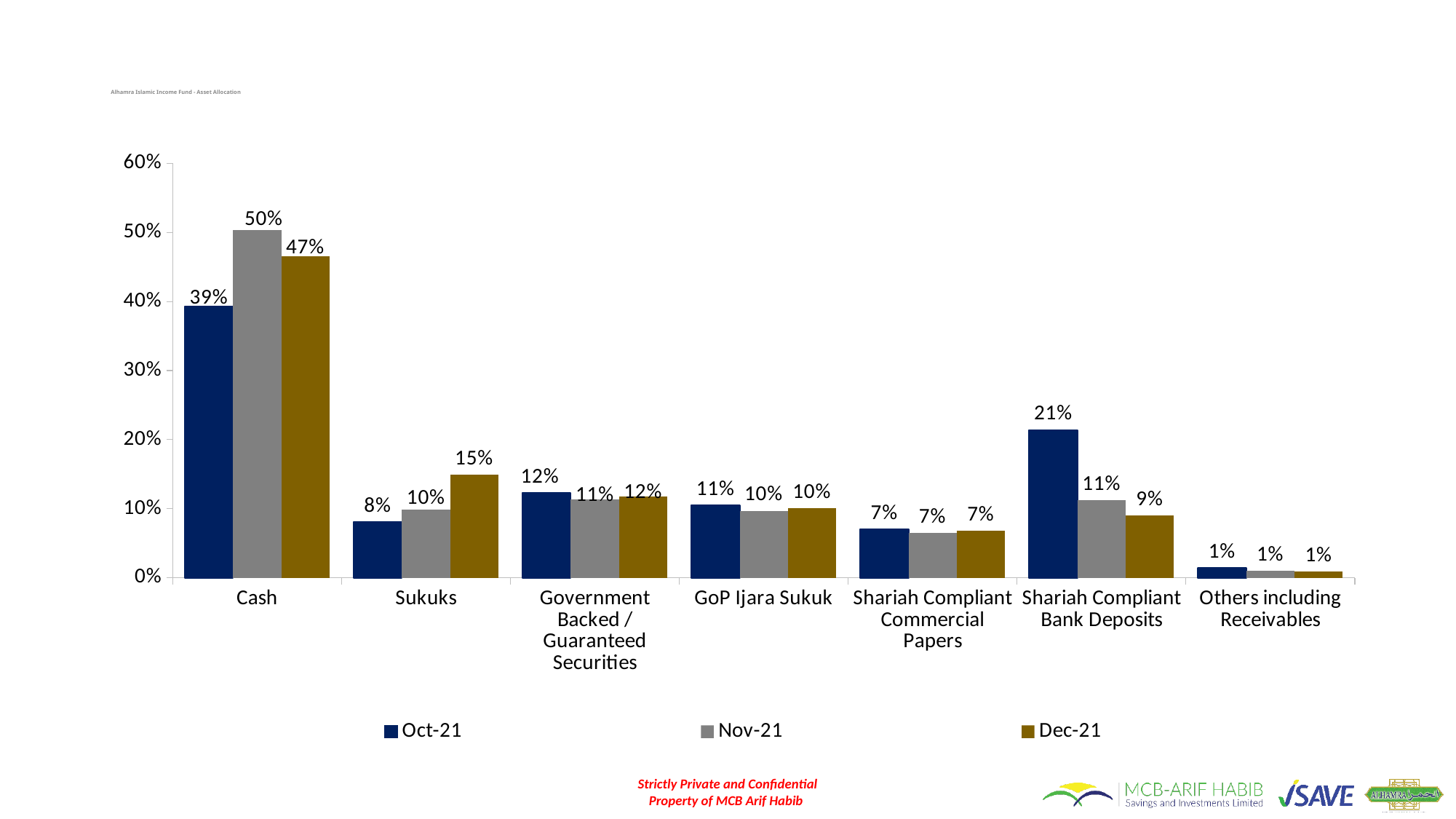
Which category has the lowest Dec-21 value? Others including Receivables What is the Oct-21 value for Shariah Compliant Bank Deposits? 21% What is the difference between the Nov-21 and Oct-21 values for Cash? 11% Which is larger for Sukuks: the Oct-21 value or the Dec-21 value? Dec-21 What is the Dec-21 value for Cash? 47% What is the difference between the Oct-21 and Dec-21 values for Shariah Compliant Bank Deposits? 12% How many categories are shown on the x axis? 7 What kind of chart is shown on the slide? Bar chart Which category has the highest Nov-21 value? Cash What is the Nov-21 value for Sukuks? 10% How many series does the legend list? 3 Is the Oct-21 value for Cash greater or less than 30%? greater